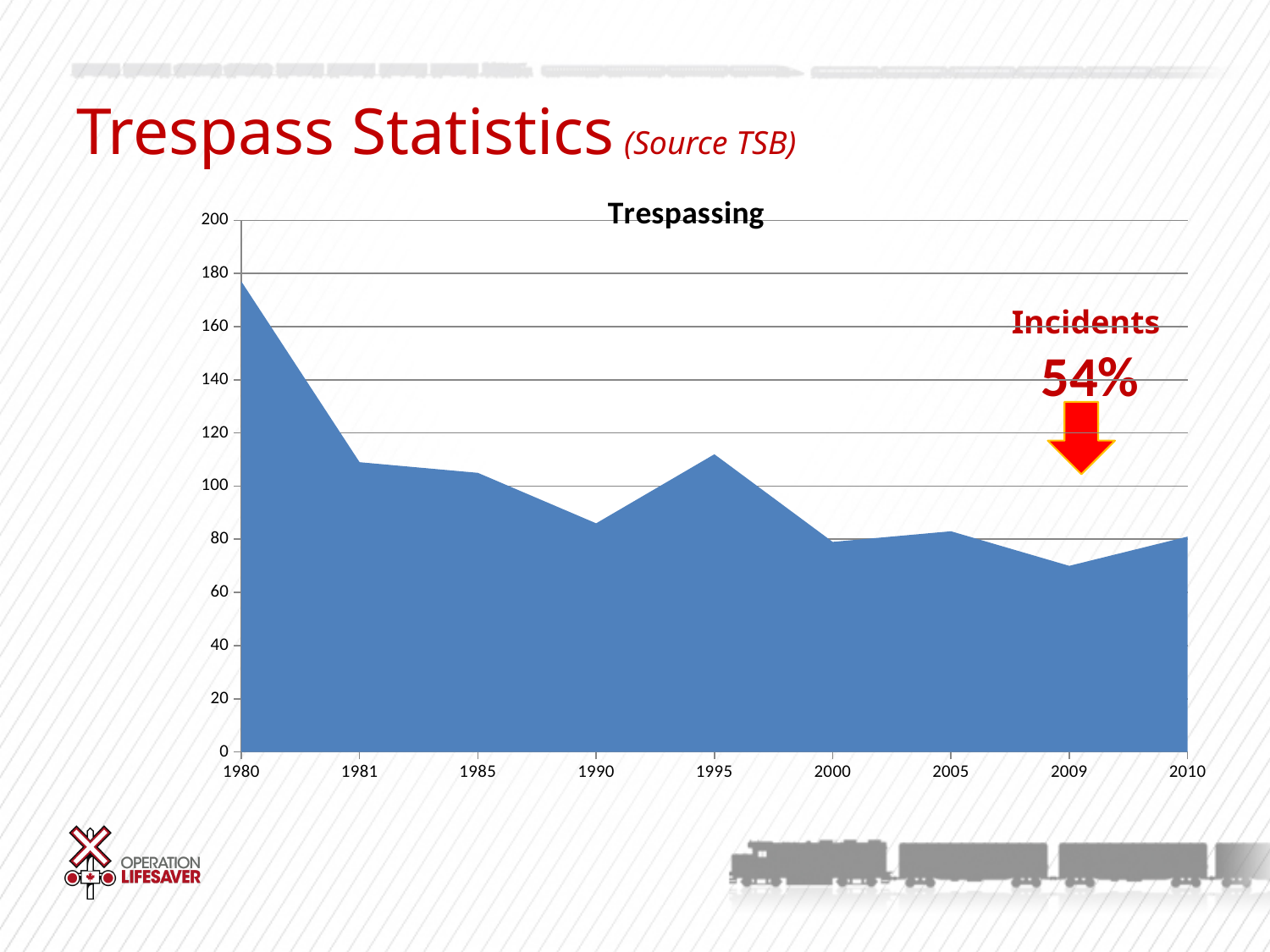
Which year has the larger value, 1990 or 1995? 1995 Is the value for 1980 greater or less than 160? greater What is the title of the chart? Trespassing Overall, do the values rise or fall from 1980 to 2010? Fall What kind of chart is shown on the slide? Area chart Is the value for 1990 greater or less than 100? less Is the value for 2009 greater or less than 80? less Which year has the highest value in the chart? 1980 Which year has the lowest value in the chart? 2009 What percentage is shown in the annotation next to the word 'Incidents' on the chart? 54% How many years are plotted along the x axis of the chart? 9